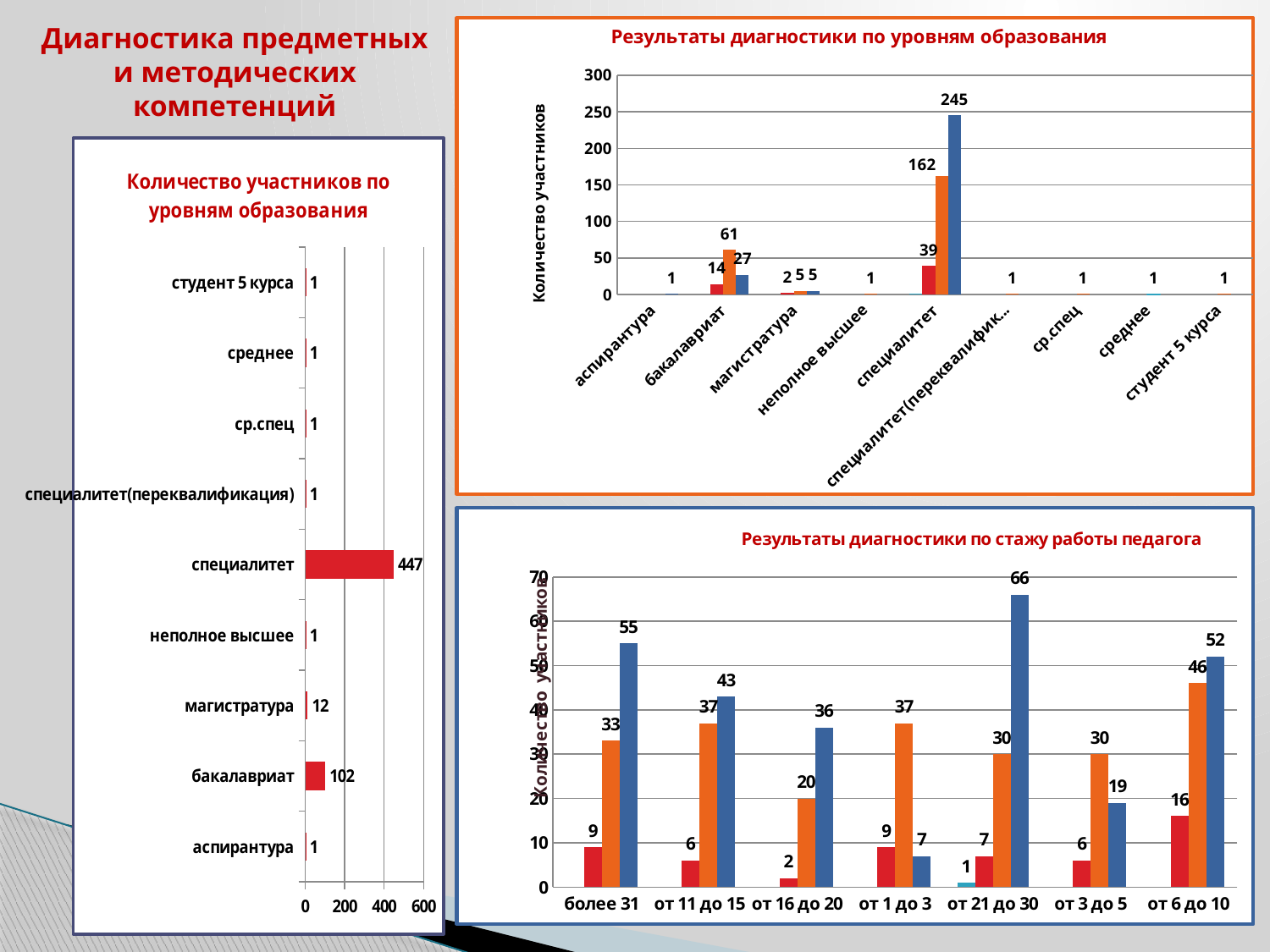
In the chart 'Результаты диагностики по стажу работы педагога', which is larger: the orange bar for от 1 до 3 or the orange bar for от 3 до 5? от 1 до 3 In the chart 'Количество участников по уровням образования', what is the difference between специалитет and бакалавриат? 345 In the chart 'Количество участников по уровням образования', how many categories are shown? 9 In the chart 'Результаты диагностики по стажу работы педагога', what is the value of the blue bar for от 21 до 30? 66 In the chart 'Результаты диагностики по стажу работы педагога', how many categories are shown on the x axis? 7 In the chart 'Результаты диагностики по уровням образования', what is the value of the orange bar for бакалавриат? 61 In the chart 'Количество участников по уровням образования', what is the value for бакалавриат? 102 In the chart 'Количество участников по уровням образования', what is the value for специалитет? 447 What type of chart is 'Количество участников по уровням образования'? bar chart In the chart 'Результаты диагностики по уровням образования', what is the difference between the blue and orange bars for специалитет? 83 In the chart 'Количество участников по уровням образования', which category has the highest value? специалитет In the chart 'Результаты диагностики по уровням образования', what is the value of the blue bar for специалитет? 245